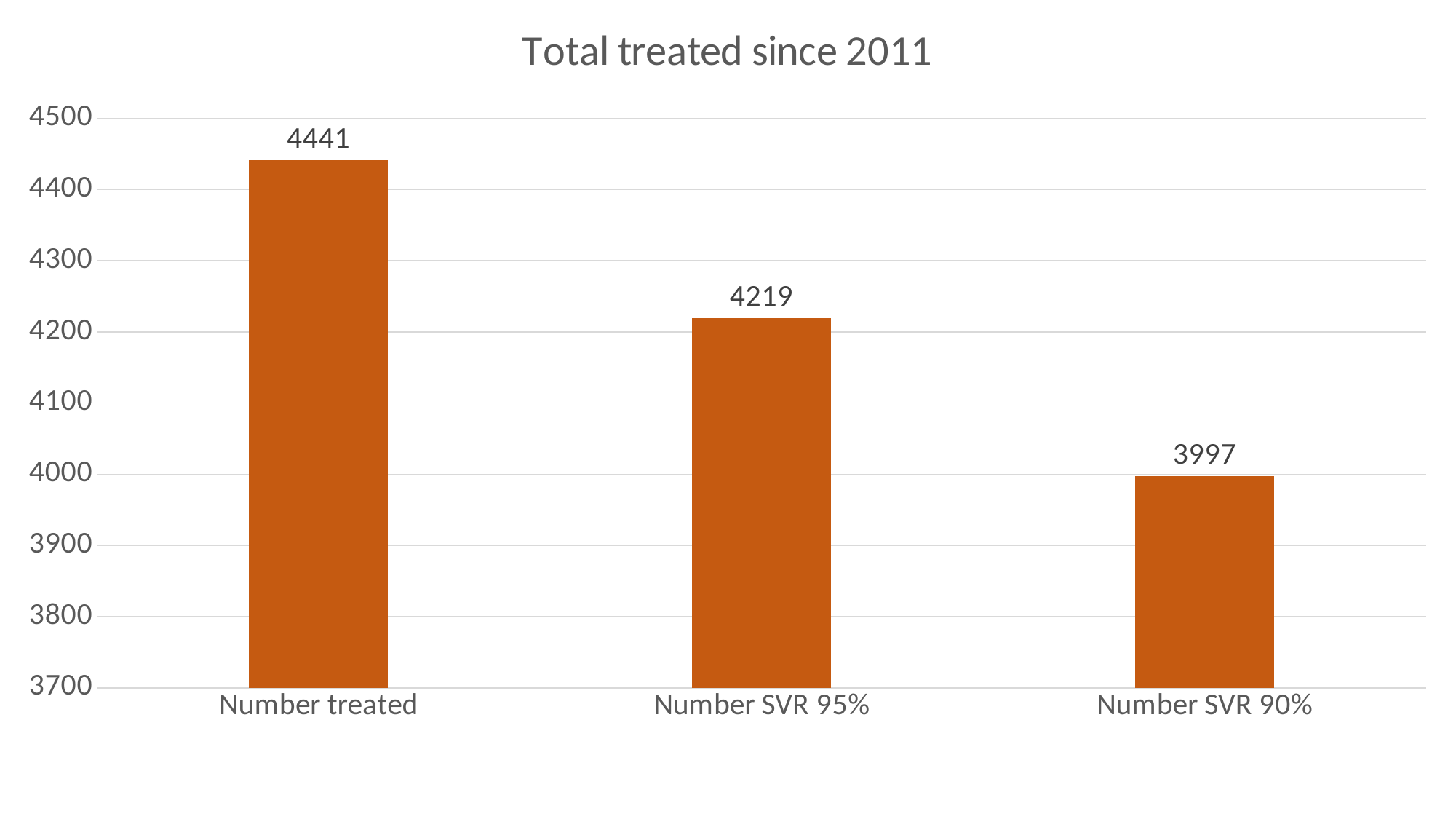
What is the title of the chart? Total treated since 2011 What is the value for Number treated? 4441 What is the value for Number SVR 95%? 4219 How many categories are shown in the chart? 3 Is the value for Number SVR 90% greater or less than 4100? less What is the value for Number SVR 90%? 3997 Which category has the highest value? Number treated What is the difference between Number SVR 95% and Number SVR 90%? 222 Which is larger, Number SVR 95% or Number SVR 90%? Number SVR 95% Which category has the lowest value? Number SVR 90% What is the difference between Number treated and Number SVR 95%? 222 What kind of chart is shown on the slide? Bar chart